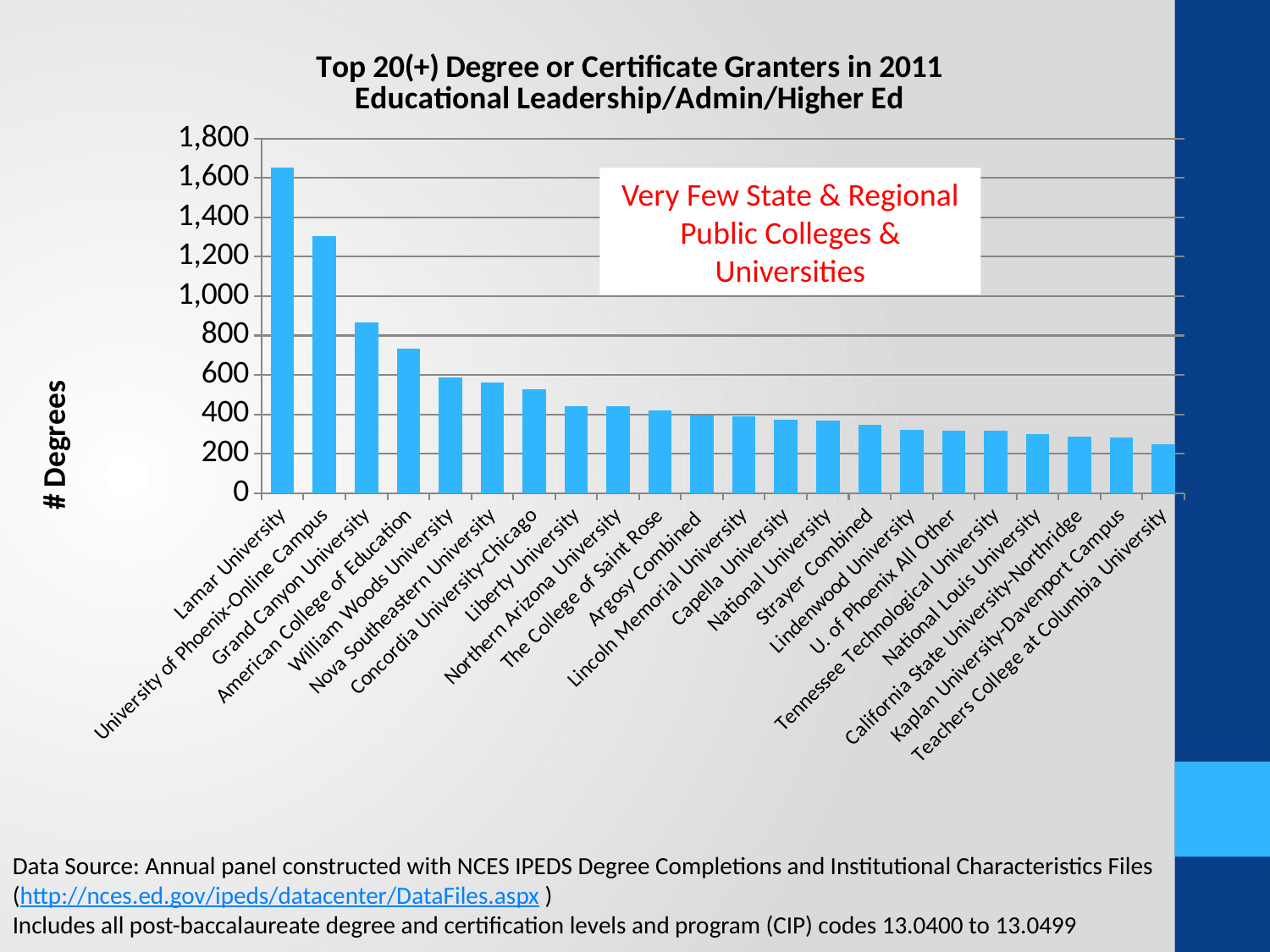
Which institution has the lowest number of degrees? Teachers College at Columbia University Which institution has the highest number of degrees? Lamar University Is the value for Grand Canyon University greater or less than 800? greater Is the value for University of Phoenix-Online Campus greater or less than 1,200? greater Is the value for American College of Education greater or less than 800? less Do the values rise or fall moving from left to right along the x axis? fall What is the label on the vertical axis? # Degrees What kind of chart is shown on the slide? bar chart Which has more degrees, Grand Canyon University or American College of Education? Grand Canyon University How many institutions are plotted on the chart? 22